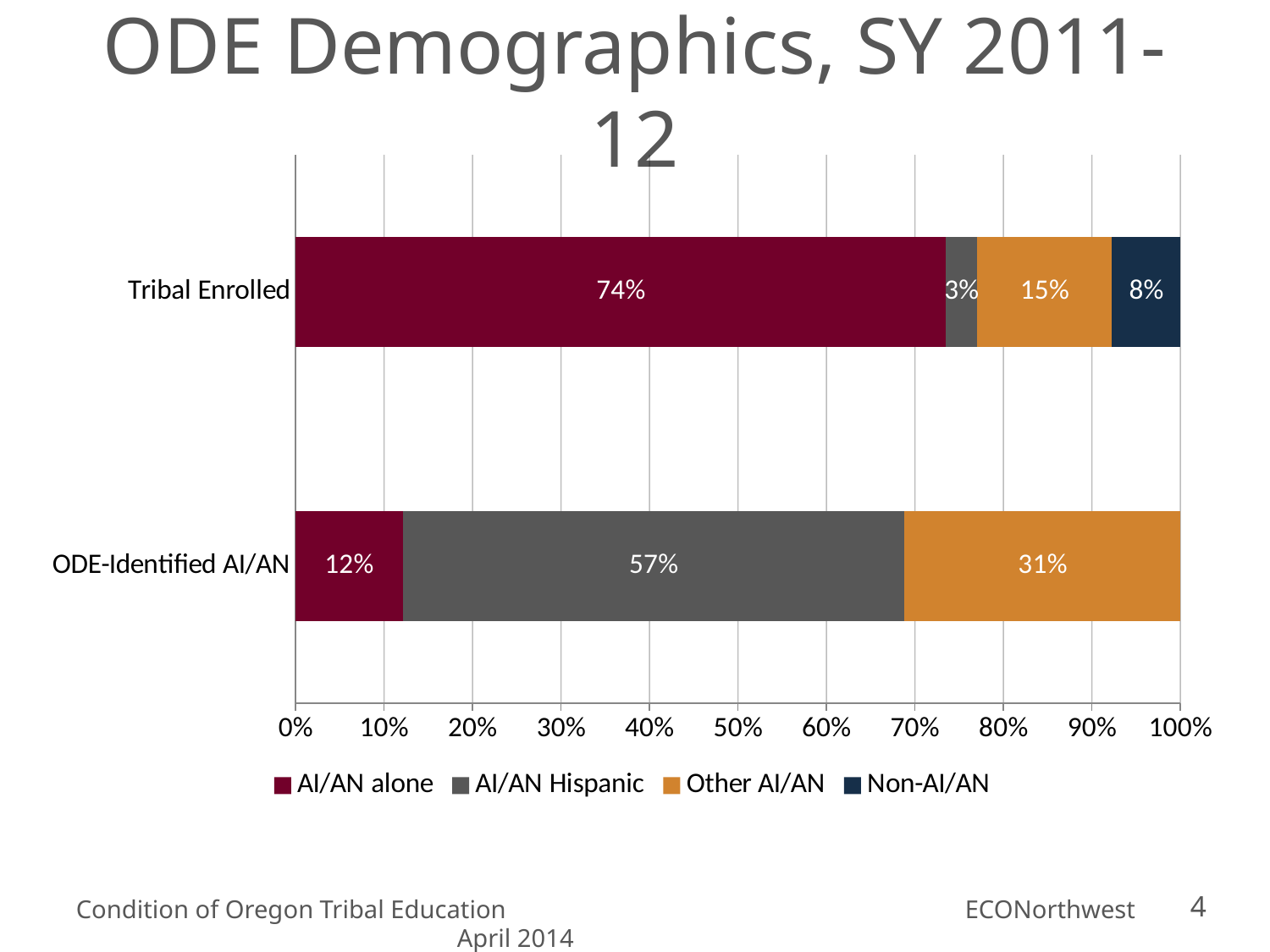
What is the AI/AN alone share for ODE-Identified AI/AN? 12% How many categories are shown on the y axis? 2 Which category has the larger AI/AN alone share, Tribal Enrolled or ODE-Identified AI/AN? Tribal Enrolled Which segment is the largest in the ODE-Identified AI/AN bar? AI/AN Hispanic What is the Non-AI/AN share for Tribal Enrolled? 8% What is the AI/AN alone share for Tribal Enrolled? 74% How many series does the legend list? 4 Which segment is the smallest in the Tribal Enrolled bar? AI/AN Hispanic What is the AI/AN Hispanic share for ODE-Identified AI/AN? 57% What is the Other AI/AN share for Tribal Enrolled? 15% What kind of chart is shown on the slide? Stacked bar chart What is the difference between the Other AI/AN share for ODE-Identified AI/AN and for Tribal Enrolled? 16%